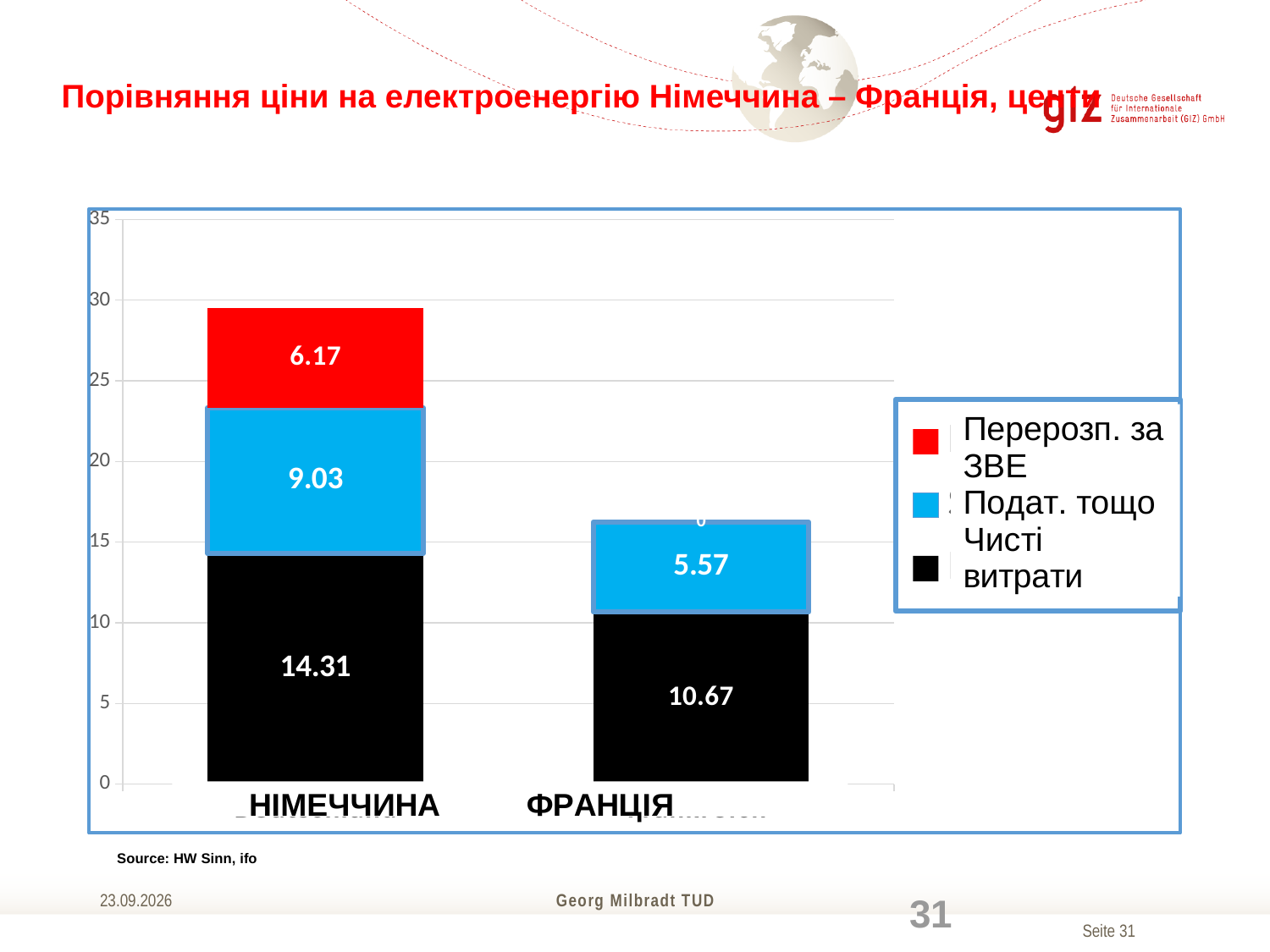
How many series does the legend list? 3 What type of chart is shown on the slide? stacked bar chart What is the value of Подат. тощо for ФРАНЦІЯ? 5.57 What is the difference between Чисті витрати for НІМЕЧЧИНА and for ФРАНЦІЯ? 3.64 What is the total of the stacked bar for НІМЕЧЧИНА? 29.51 What is the value of Чисті витрати for НІМЕЧЧИНА? 14.31 Is the total of the stacked bar for ФРАНЦІЯ greater or less than 20? less What is the value of Перерозп. за ЗВЕ for НІМЕЧЧИНА? 6.17 What is the value of Чисті витрати for ФРАНЦІЯ? 10.67 How many countries are shown on the x axis? 2 What is the value of Подат. тощо for НІМЕЧЧИНА? 9.03 Which country has the larger Подат. тощо value, НІМЕЧЧИНА or ФРАНЦІЯ? НІМЕЧЧИНА